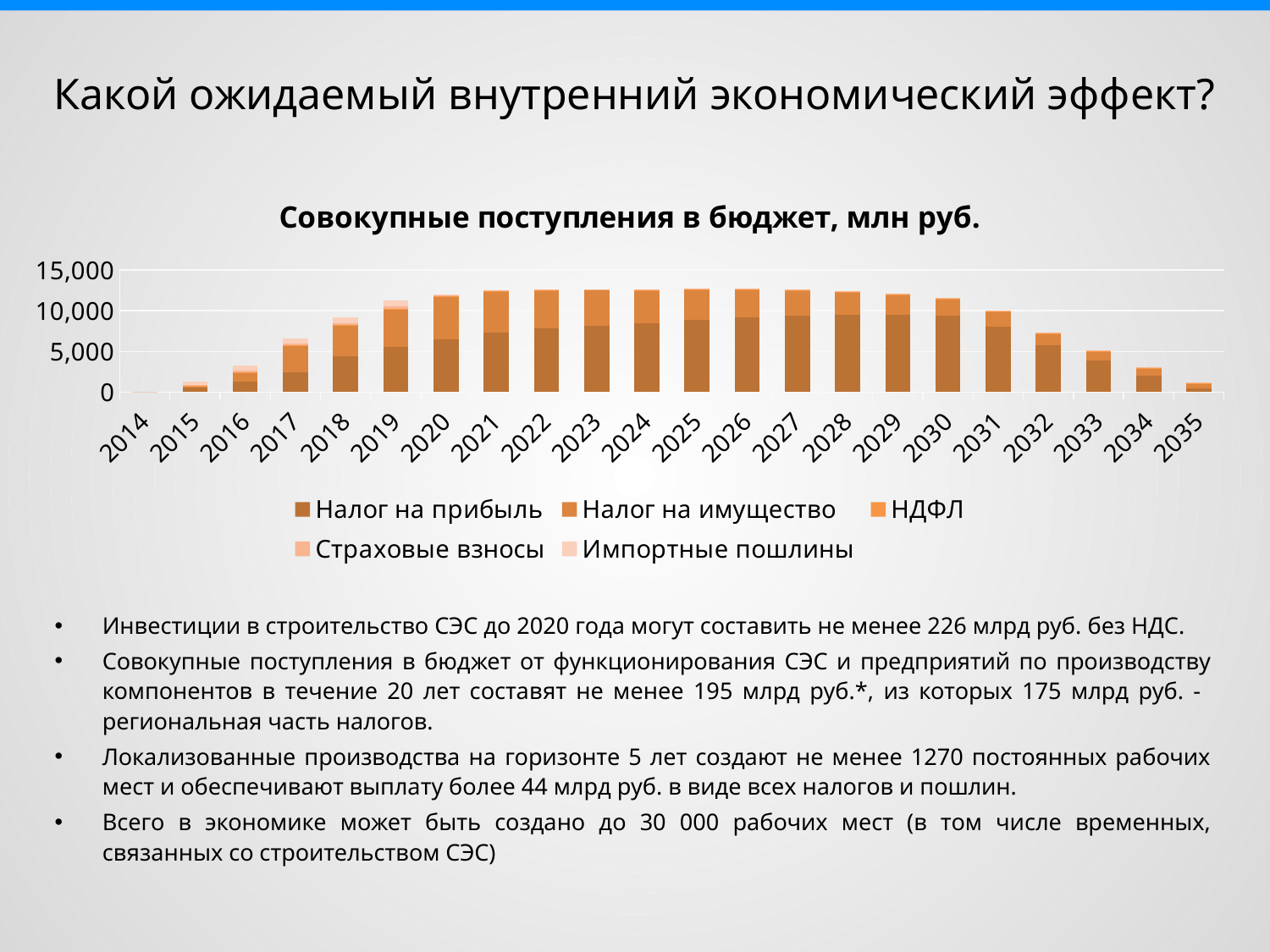
Which year has the lowest total bar in the chart? 2014 Is the total value for 2035 greater or less than 5,000? less Which year has the larger total bar, 2018 or 2033? 2018 How many series does the chart legend list? 5 Is the total value for 2020 greater or less than 10,000? greater Do the total bar values rise or fall from 2014 to 2020? Rise What is the title of the chart? Совокупные поступления в бюджет, млн руб. Is the total value for 2032 greater or less than 10,000? less What kind of chart is shown on the slide? Bar chart How many years are shown on the x axis of the chart? 22 Do the total bar values rise or fall from 2030 to 2035? Fall